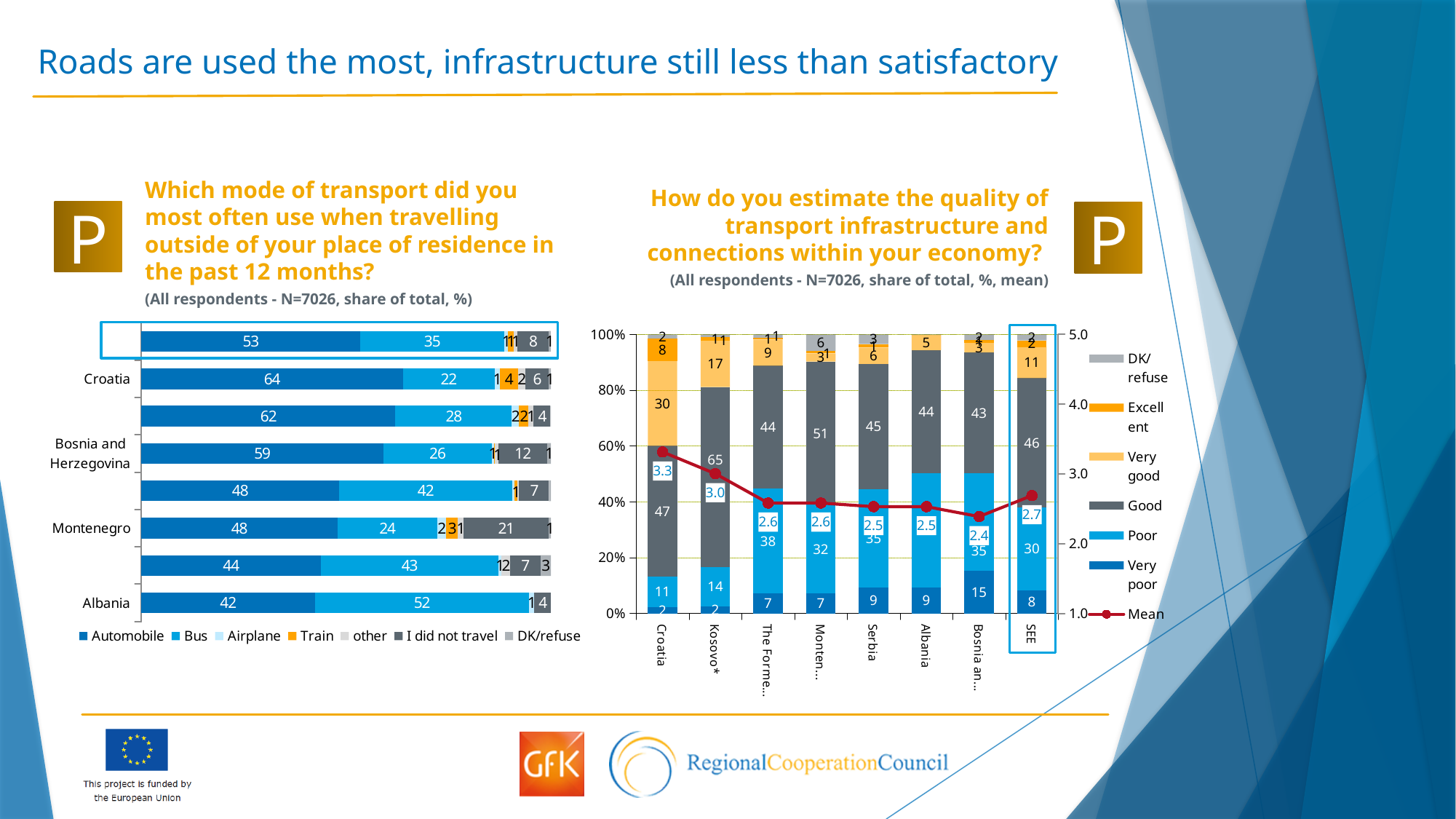
In the right chart on quality of transport infrastructure, what is the Poor value for SEE? 30 In the right chart on quality of transport infrastructure, which economy has the highest Mean value? Croatia In the left chart on mode of transport, how many series does the legend list? 7 In the left chart on mode of transport, what is the Bus value for Albania? 52 What kind of chart is the left chart on mode of transport? Stacked bar chart In the right chart on quality of transport infrastructure, what is the Mean value for Croatia? 3.3 In the right chart on quality of transport infrastructure, what is the lowest Mean value shown? 2.4 In the right chart on quality of transport infrastructure, how many economies/categories are shown on the x axis? 8 In the left chart on which mode of transport was used most often, what percentage of respondents in Croatia chose Automobile? 64 In the left chart on mode of transport, what is the 'I did not travel' value for Montenegro? 21 In the left chart on mode of transport, how much higher is the Automobile value for Croatia than for Bosnia and Herzegovina? 5 In the right chart on quality of transport infrastructure, what is the Good value for Kosovo*? 65